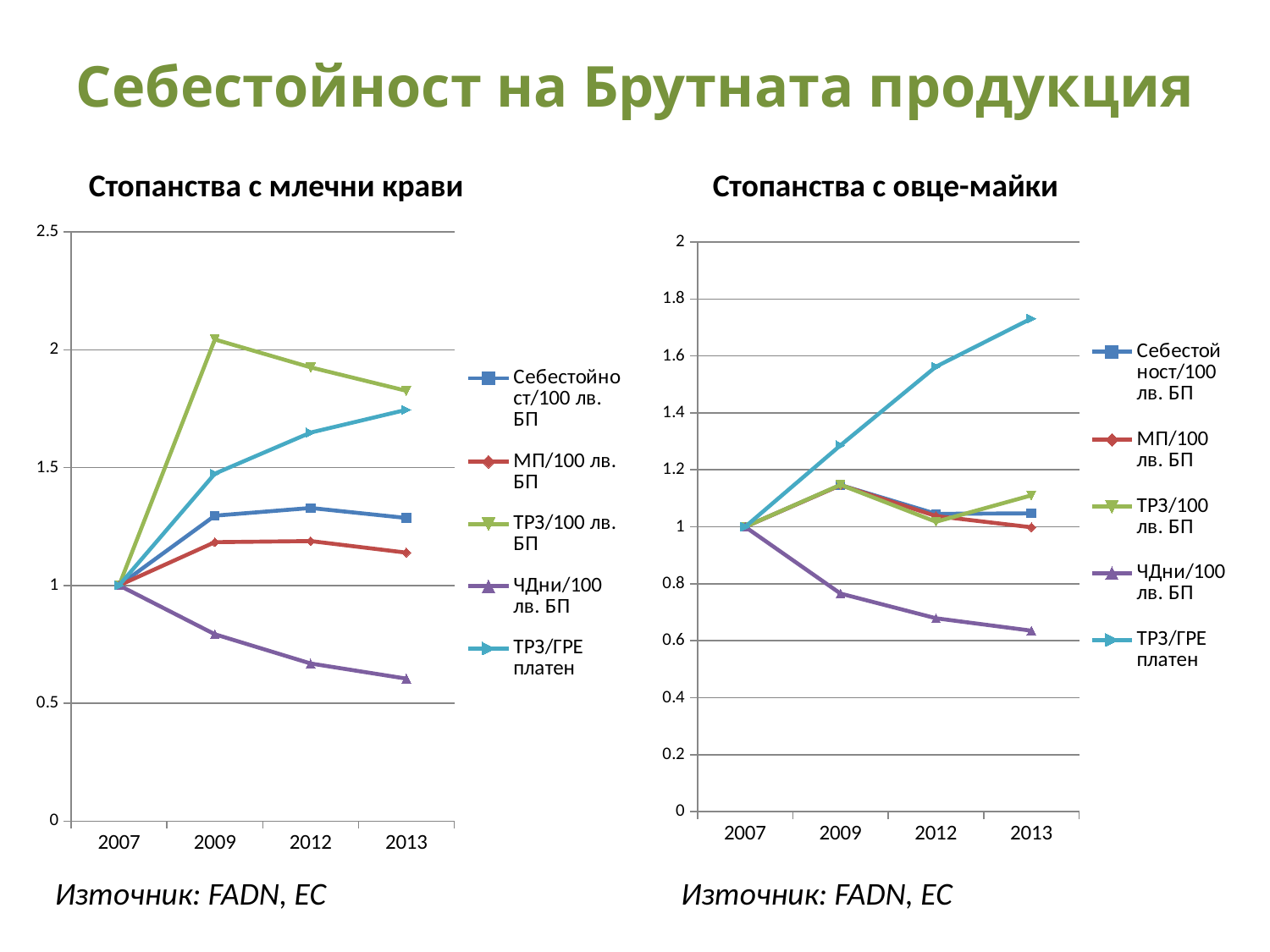
In the 'Стопанства с овце-майки' chart, does 'ТРЗ/ГРЕ платен' rise or fall from 2007 to 2013? rise In the 'Стопанства с млечни крави' chart, which series has the highest value in 2009? ТРЗ/100 лв. БП What type of chart is the 'Стопанства с млечни крави' chart? line chart In the 'Стопанства с млечни крави' chart, what is the value of 'Себестойност/100 лв. БП' in 2007? 1 In the 'Стопанства с млечни крави' chart, is the value for 'ТРЗ/ГРЕ платен' in 2013 greater or less than 1.5? greater In the 'Стопанства с овце-майки' chart, is the value for 'ЧДни/100 лв. БП' in 2013 greater or less than 0.8? less In the 'Стопанства с млечни крави' chart, does 'ЧДни/100 лв. БП' rise or fall from 2007 to 2013? fall How many series does the legend of the 'Стопанства с овце-майки' chart list? 5 How many years are shown on the x axis of the 'Стопанства с млечни крави' chart? 4 In the 'Стопанства с овце-майки' chart, which series has the highest value in 2013? ТРЗ/ГРЕ платен In the 'Стопанства с млечни крави' chart, which is larger in 2009: 'ТРЗ/100 лв. БП' or 'ТРЗ/ГРЕ платен'? ТРЗ/100 лв. БП In the 'Стопанства с млечни крави' chart, which series has the lowest value in 2013? ЧДни/100 лв. БП